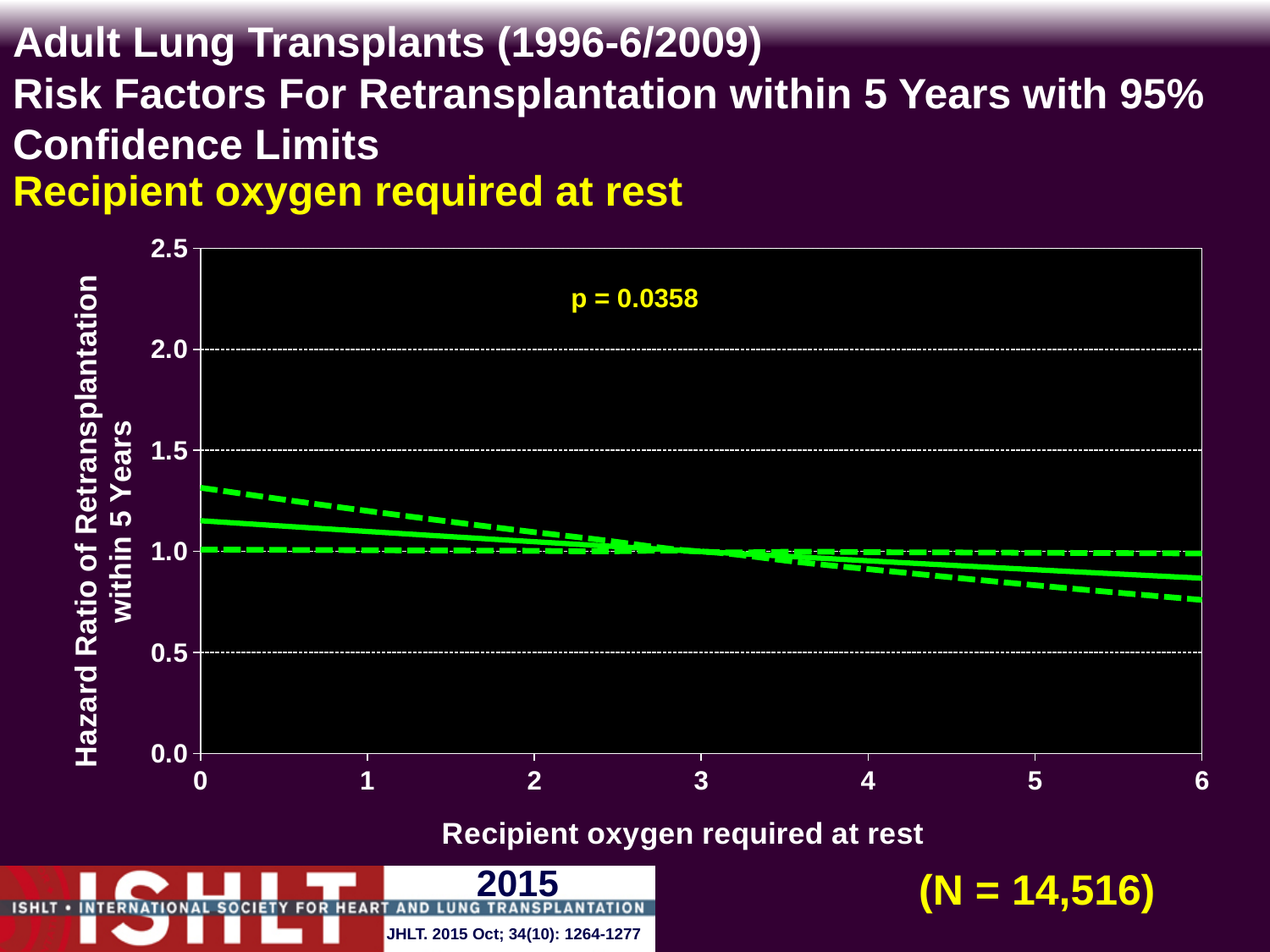
What p-value is printed on the chart? p = 0.0358 What kind of chart is shown on the slide? line chart What is the highest value shown on the x axis? 6 Which is larger, the hazard ratio (solid line) at a recipient oxygen value of 0 or at a value of 6? at 0 Is the hazard ratio (solid line) at a recipient oxygen value of 0 greater or less than 1.0? greater Is the hazard ratio (solid line) at a recipient oxygen value of 6 greater or less than 1.0? less Does the solid hazard ratio line rise or fall as recipient oxygen required at rest increases from 0 to 6? fall What is the label of the x axis? Recipient oxygen required at rest Is the lower 95% confidence limit (lower dashed line) at a recipient oxygen value of 6 greater or less than 0.5? greater How many lines are plotted on the chart? 3 What is the highest value shown on the y axis? 2.5